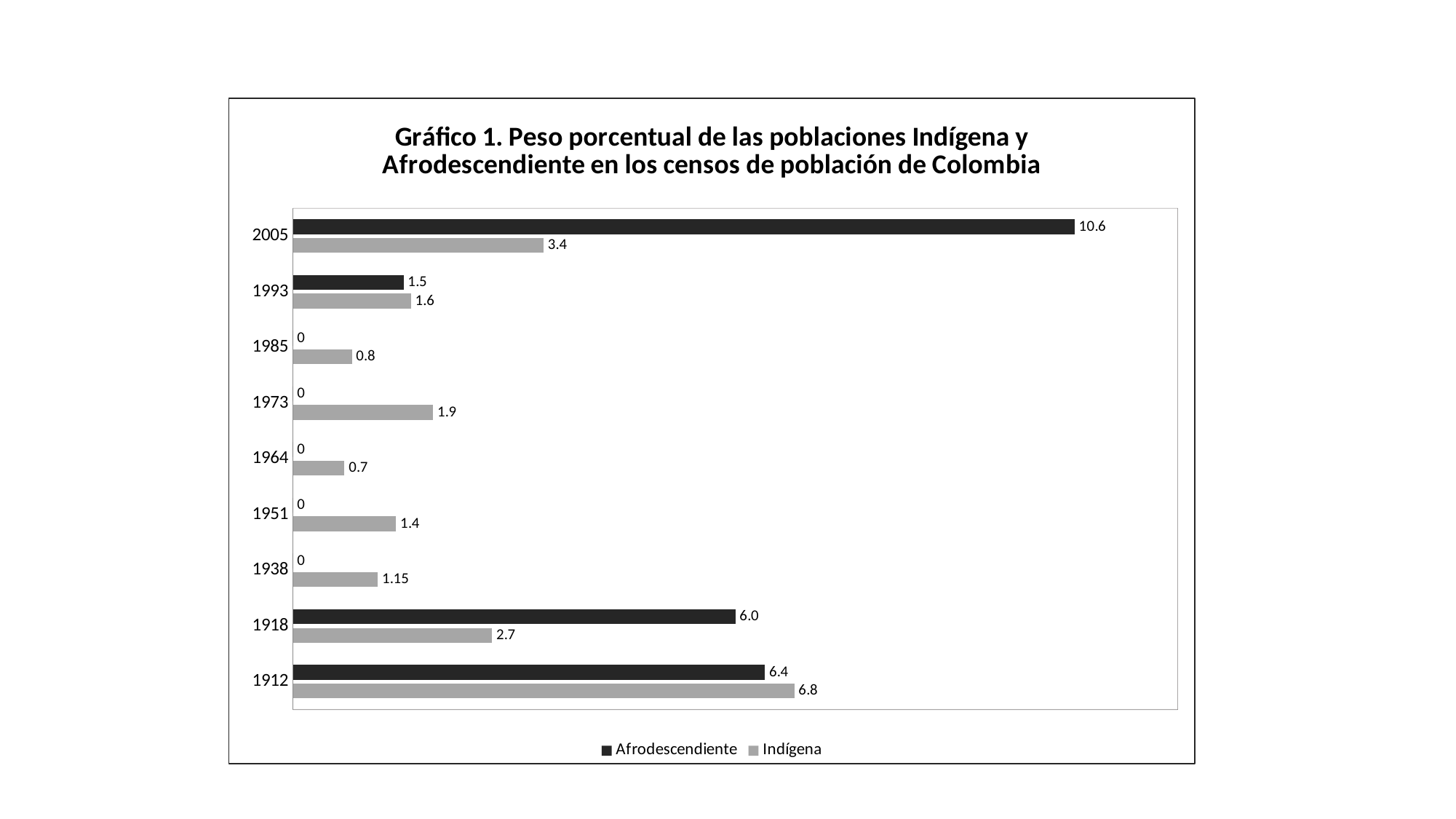
What is the Afrodescendiente value for 2005? 10.6 Which series is shown in dark bars according to the legend? Afrodescendiente Which census year has the highest Afrodescendiente value? 2005 How many census years are shown on the chart? 9 Which census year has the lowest Indígena value? 1964 What is the difference between the Afrodescendiente and Indígena values for 2005? 7.2 How many series does the legend list? 2 What is the Indígena value for 1938? 1.15 What is the Afrodescendiente value for 1985? 0 What kind of chart is shown on the slide? Bar chart Which is larger for 1918, the Afrodescendiente value or the Indígena value? Afrodescendiente What is the Indígena value for 1912? 6.8